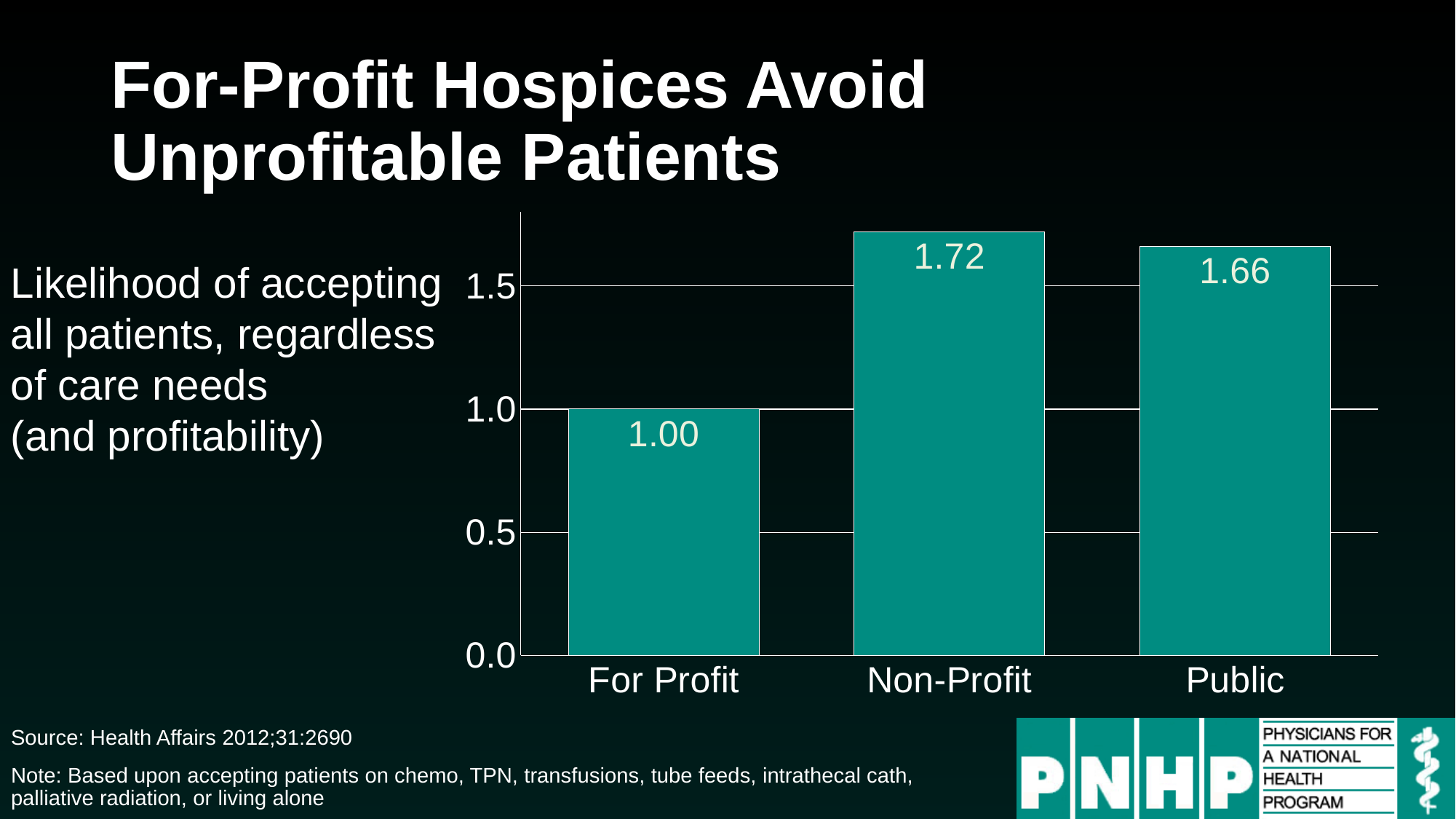
Which is larger, the value for Public or the value for For Profit? Public What is the value for For Profit? 1.00 What kind of chart is shown on the slide? bar chart How many categories are shown on the x axis? 3 What is the title of the slide containing the chart? For-Profit Hospices Avoid Unprofitable Patients Is the value for Public greater or less than 1.5? greater Which category has the lowest value? For Profit What is the value for Public? 1.66 What is the difference between the values for Non-Profit and For Profit? 0.72 What is the value for Non-Profit? 1.72 What is the difference between the values for Non-Profit and Public? 0.06 Which category has the highest value? Non-Profit